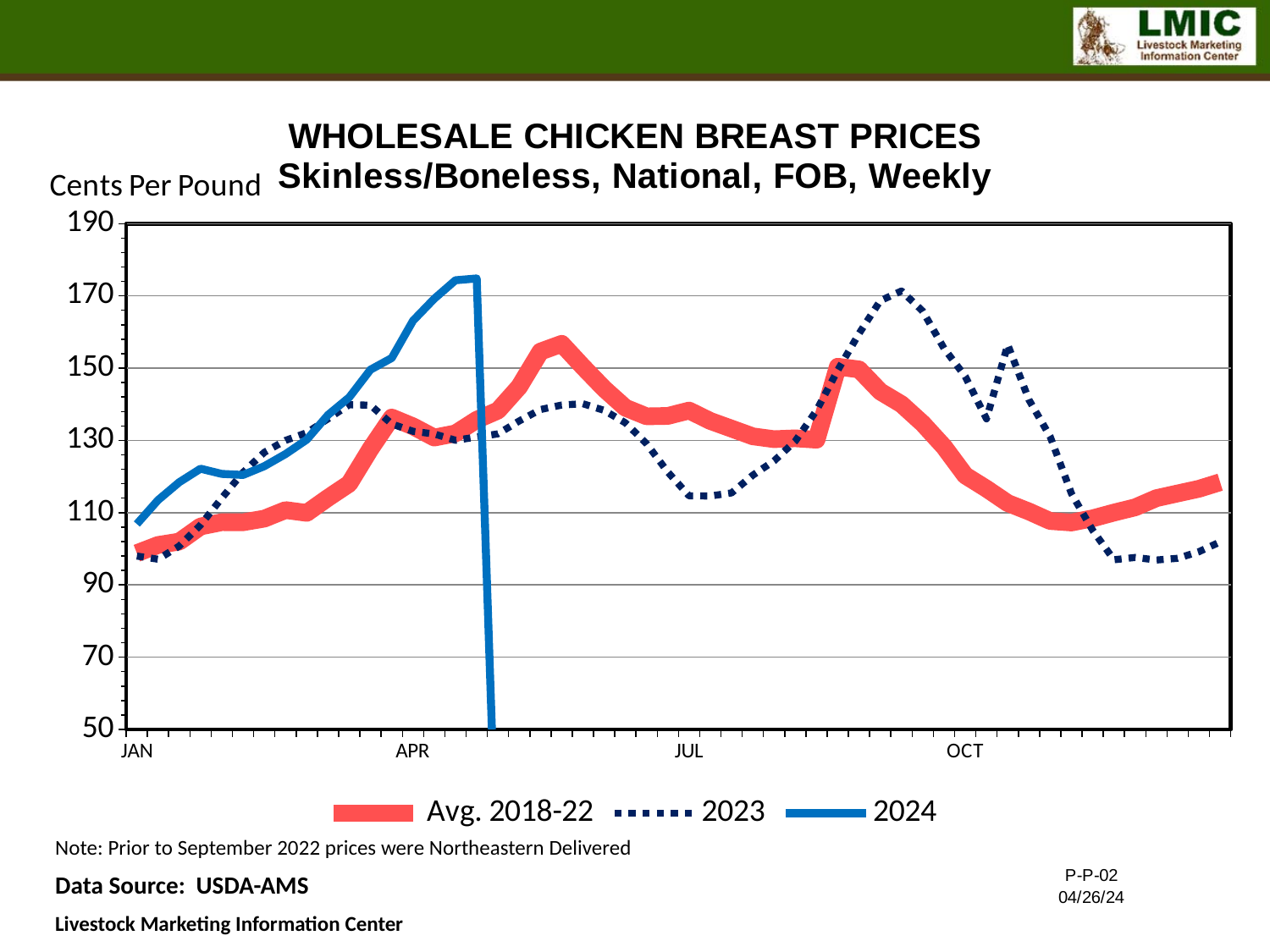
Does the 2023 line rise or fall from October to the end of the year? fall Does the 2024 line rise or fall from January to early April? rise What is the label on the vertical axis of the chart? Cents Per Pound How many series does the legend list? 3 At the start of January, which is higher: the 2024 line or the 2023 line? 2024 What kind of chart is shown on the slide? line chart Is the peak value of the 2024 line greater or less than 170? greater Which series is drawn as a dotted line in the chart? 2023 Around October, which is higher: the 2023 line or the Avg. 2018-22 line? 2023 Is the value of the 2023 line in mid-July greater or less than 130? less Is the value of the Avg. 2018-22 line at the start of January greater or less than 110? less